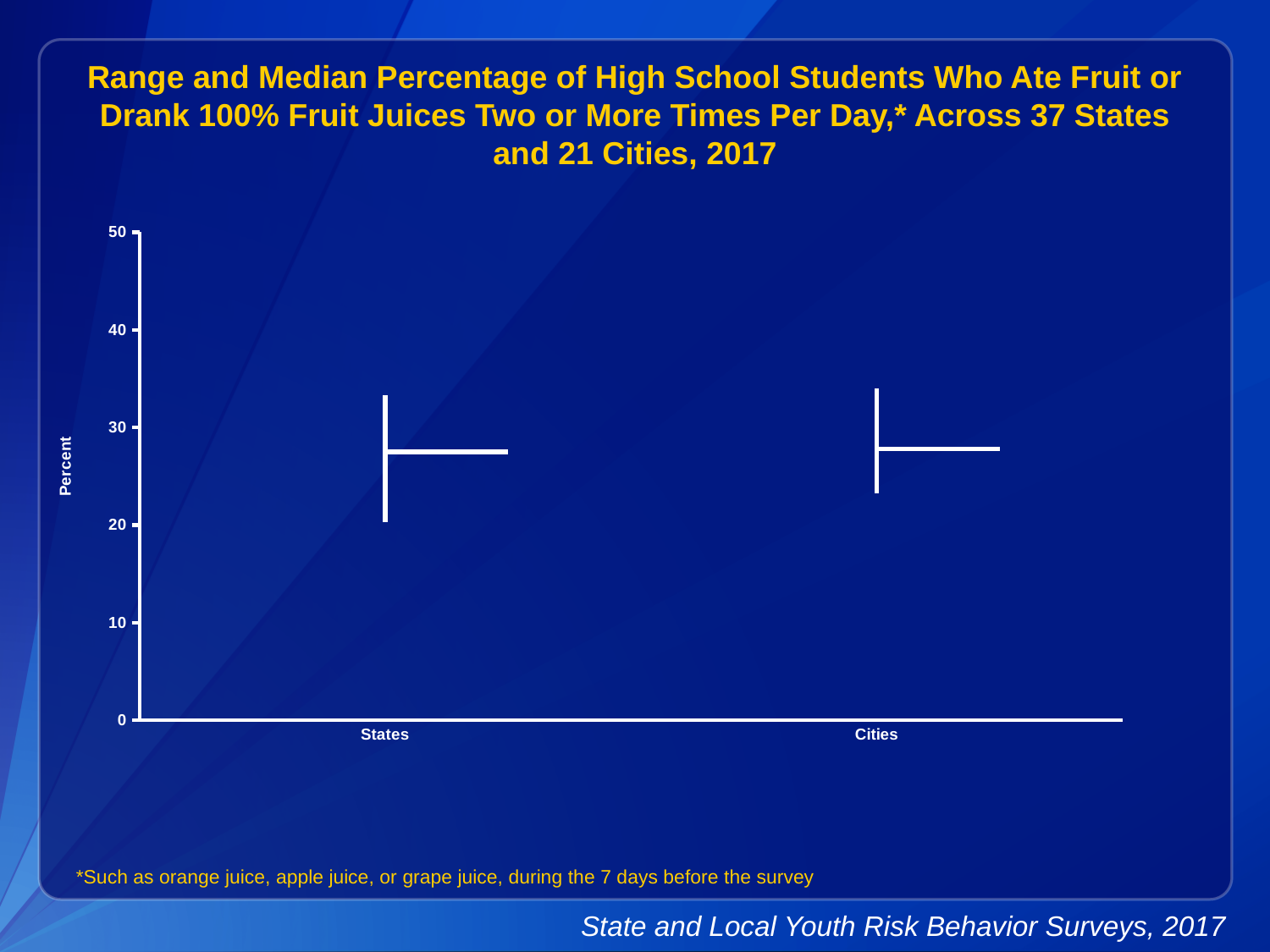
Is the median value for Cities greater or less than 30? less What is the label on the y axis of the chart? Percent How many categories are shown on the x axis of the chart? 2 Is the top of the range for Cities greater or less than 40? less What are the two categories shown on the x axis? States and Cities Is the median value for Cities greater or less than 20? greater What is the highest value shown on the y axis of the chart? 50 Which category has the higher bottom of its range, States or Cities? Cities